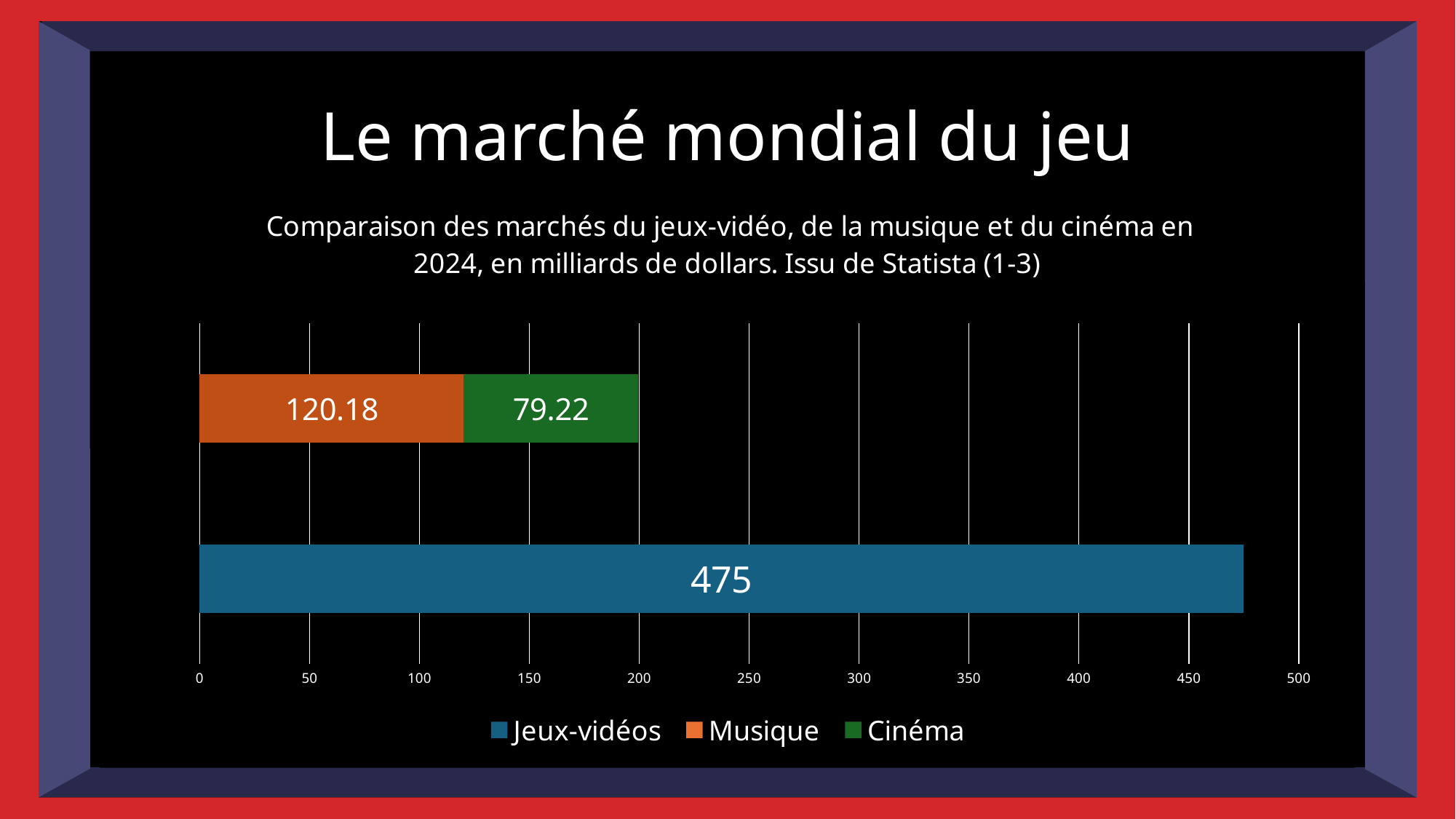
Which series has the lowest value? Cinéma What is the difference between the Musique value and the Cinéma value? 40.96 Which series has the highest value? Jeux-vidéos What is the value shown for Musique? 120.18 What colour is the Jeux-vidéos bar? Blue How many series does the legend list? 3 What kind of chart is shown on the slide? Bar chart Which is larger, the value for Musique or the value for Cinéma? Musique What is the difference between the Jeux-vidéos value and the Musique value? 354.82 What is the value shown for Jeux-vidéos? 475 What is the value shown for Cinéma? 79.22 What is the total of the stacked bar containing Musique and Cinéma? 199.40